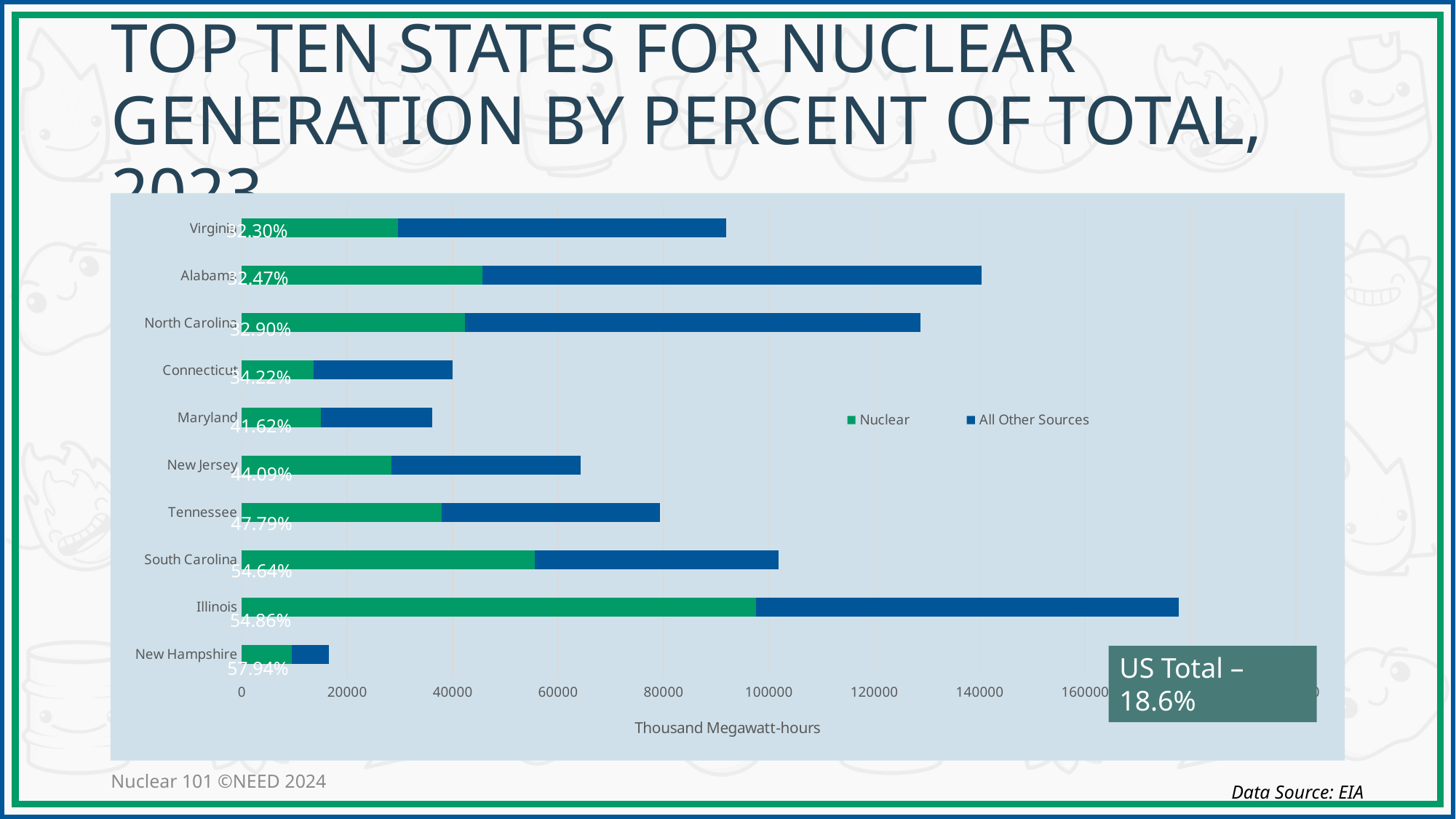
What nuclear percentage is labeled for New Hampshire? 57.94% Is the total bar for Connecticut greater or less than 60000 thousand megawatt-hours? less Which state has a longer total bar, Alabama or Virginia? Alabama What nuclear percentage is labeled for Illinois? 54.86% What nuclear percentage is labeled for Virginia? 32.30% What type of chart is shown on the slide? Stacked bar chart How many states are shown in the chart? 10 Which state has the shortest total bar (smallest total generation)? New Hampshire Which state has the longest total bar (largest total generation)? Illinois How many series does the legend list? 2 Is the total bar for Illinois greater or less than 160000 thousand megawatt-hours? greater What is the x-axis title of the chart? Thousand Megawatt-hours